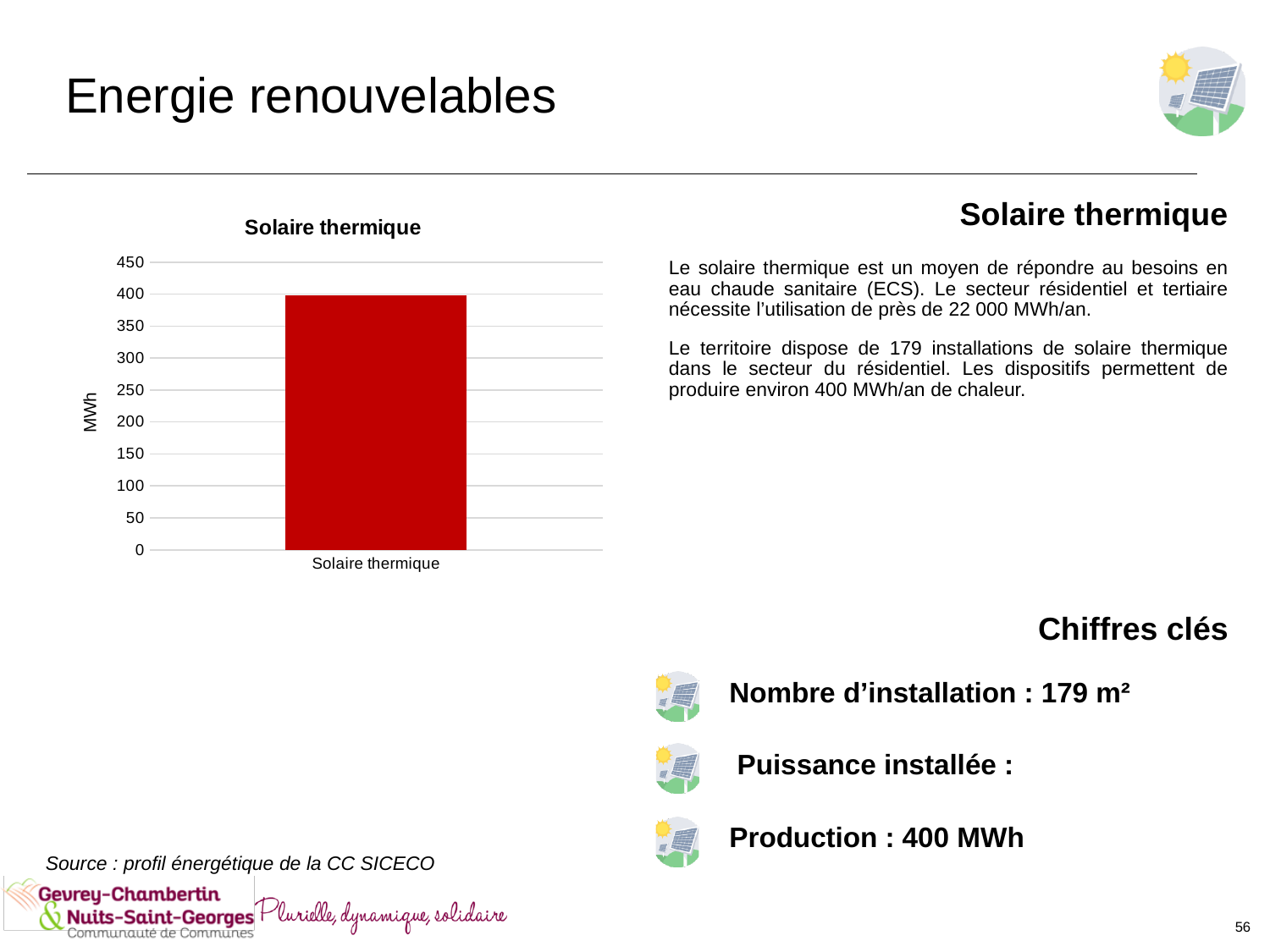
What is the title of the chart? Solaire thermique Is the value for Solaire thermique greater or less than 450? less Is the value for Solaire thermique greater or less than 350? greater What unit is shown on the y axis of the chart? MWh What is the highest value shown on the y axis of the chart? 450 What is the label of the category on the x axis of the chart? Solaire thermique What kind of chart is shown on the slide? bar chart Is the value for Solaire thermique greater or less than 200? greater How many bars does the chart show? 1